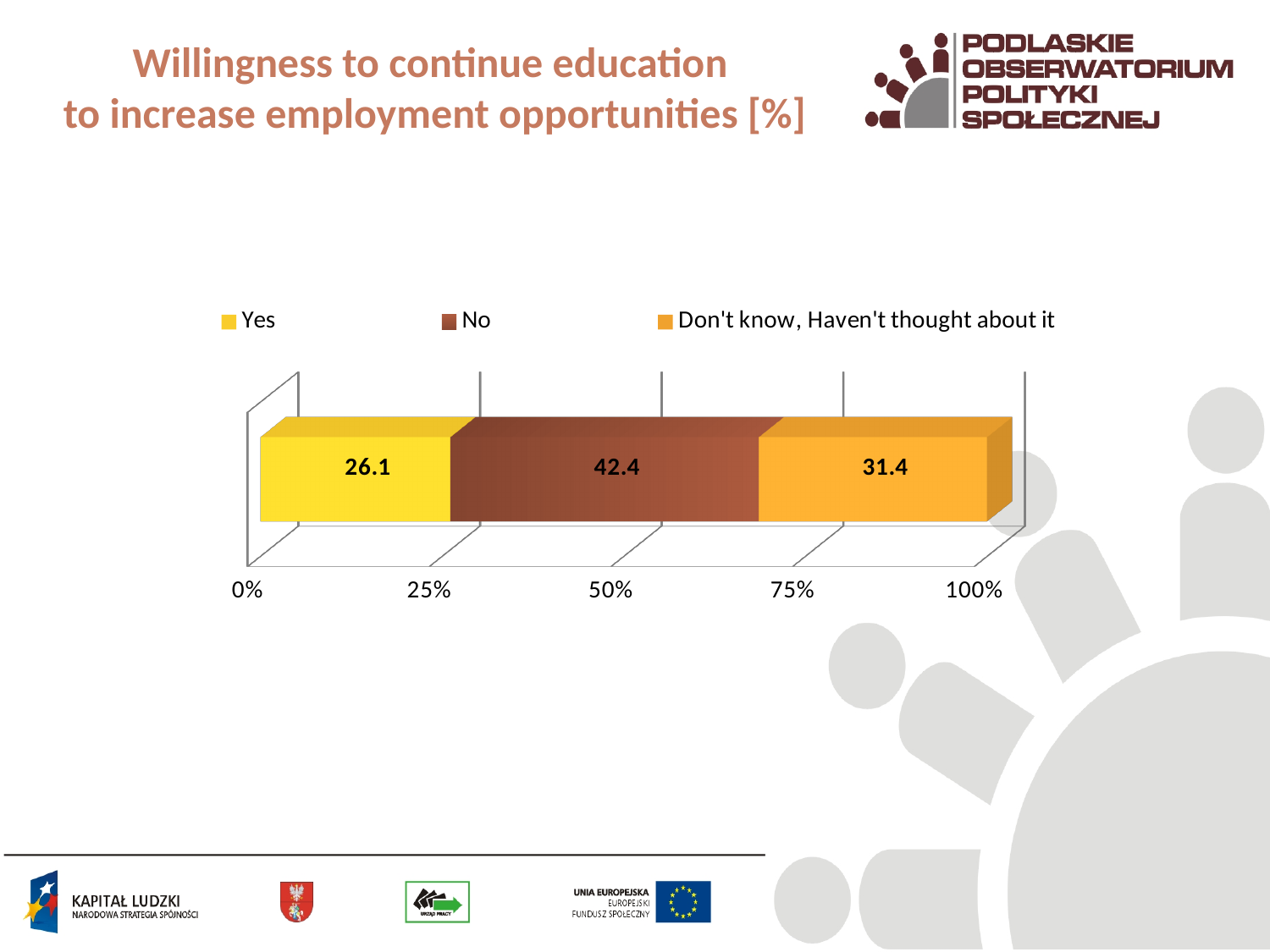
Which response has the lowest value? Yes How many series does the legend list? 3 Which is larger, the value for "No" or the value for "Don't know, Haven't thought about it"? No What is the difference between the values for "No" and "Yes"? 16.3 Which response has the highest value? No What kind of chart is shown on the slide? stacked bar chart What colour represents "No" in the chart? brown What is the total of the stacked bar? 99.9 What is the value for "Yes"? 26.1 What is the value for "No"? 42.4 Is the value for "Yes" greater or less than 50%? less What is the value for "Don't know, Haven't thought about it"? 31.4